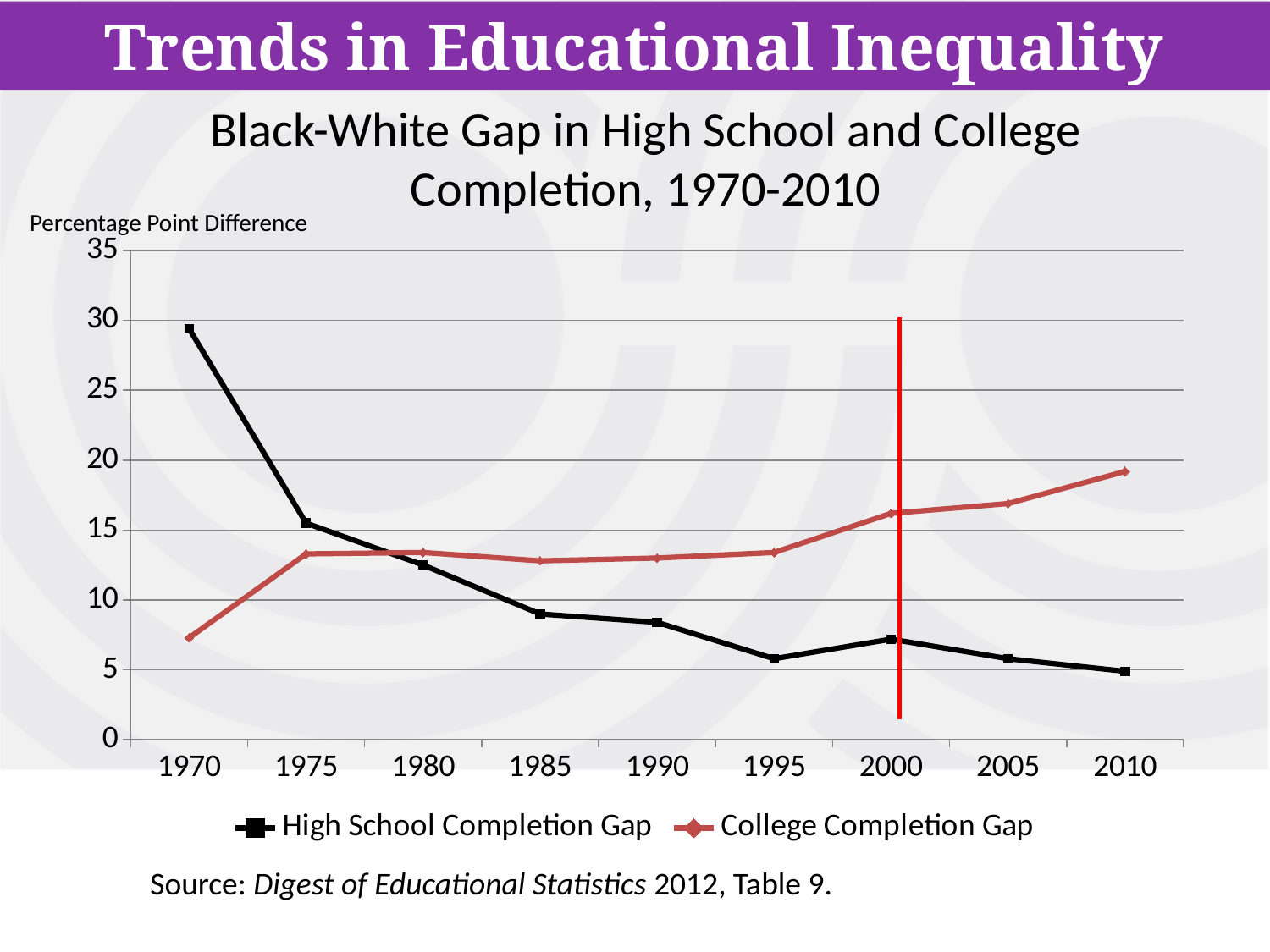
How many series does the legend list? 2 What kind of chart is shown on the slide? Line chart Is the College Completion Gap in 1970 greater or less than 10? less What is the label on the y axis of the chart? Percentage Point Difference In 1990, which is larger: the High School Completion Gap or the College Completion Gap? College Completion Gap Is the College Completion Gap in 2010 greater or less than 15? greater How many years are plotted along the x axis? 9 In which year is the College Completion Gap highest? 2010 In which year is the College Completion Gap lowest? 1970 Does the High School Completion Gap generally rise or fall from 1970 to 2010? Fall In which year is the High School Completion Gap highest? 1970 Is the High School Completion Gap in 1970 greater or less than 25? greater